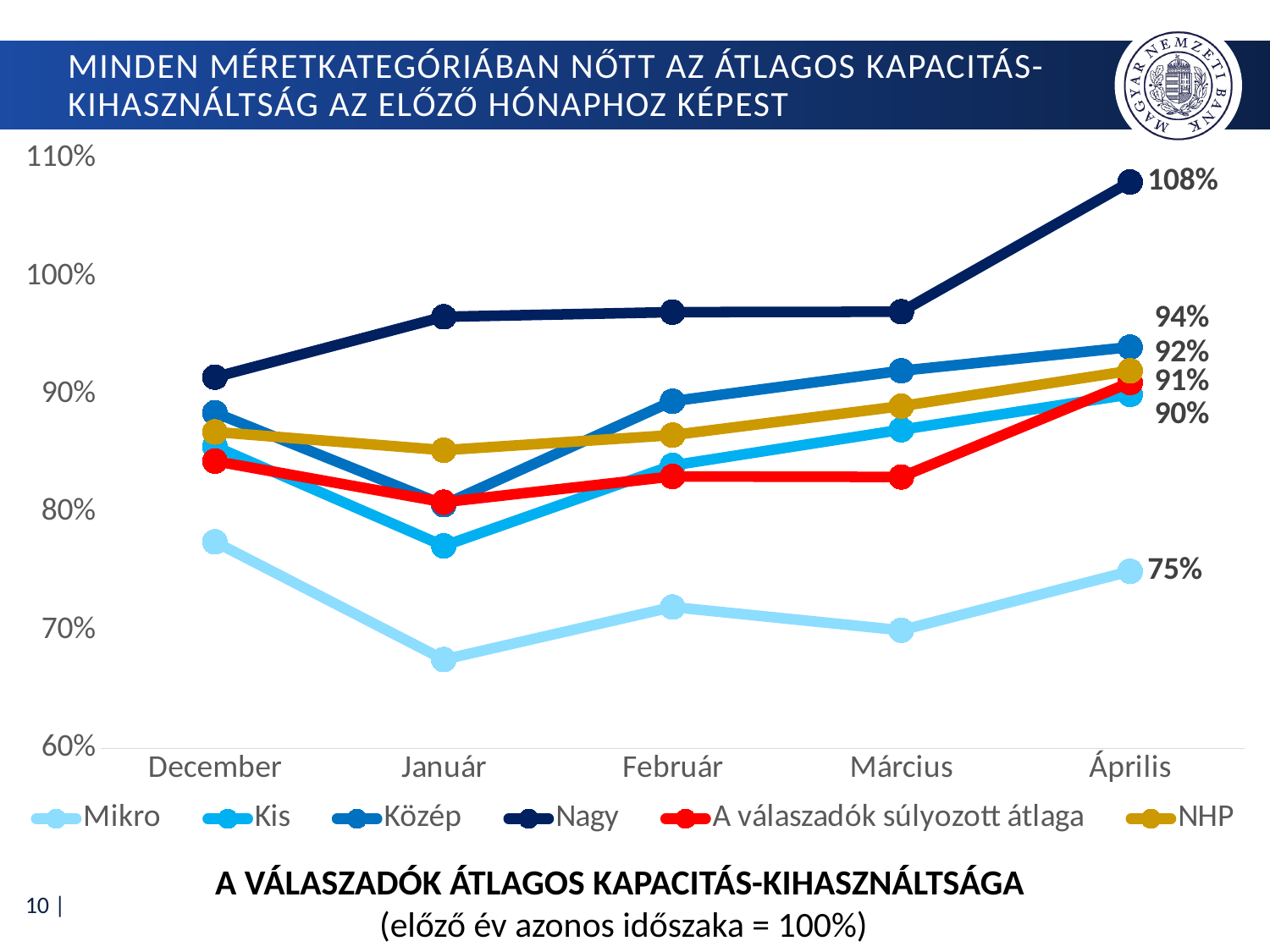
Is the value for Mikro in Január greater or less than 70%? less Which series has the lowest value in Április? Mikro Does the Nagy series rise or fall from December to Április? rises What is the value for Közép in Április? 94% What is the value for Mikro in Április? 75% Is the value for Nagy in December greater or less than 90%? greater How many months are shown on the x axis? 5 What kind of chart is shown on the slide? line chart How many series does the legend list? 6 Which series has the highest value in Április? Nagy What is the value for Nagy in Április? 108% What is the difference between the Nagy and Mikro values in Április? 33 percentage points